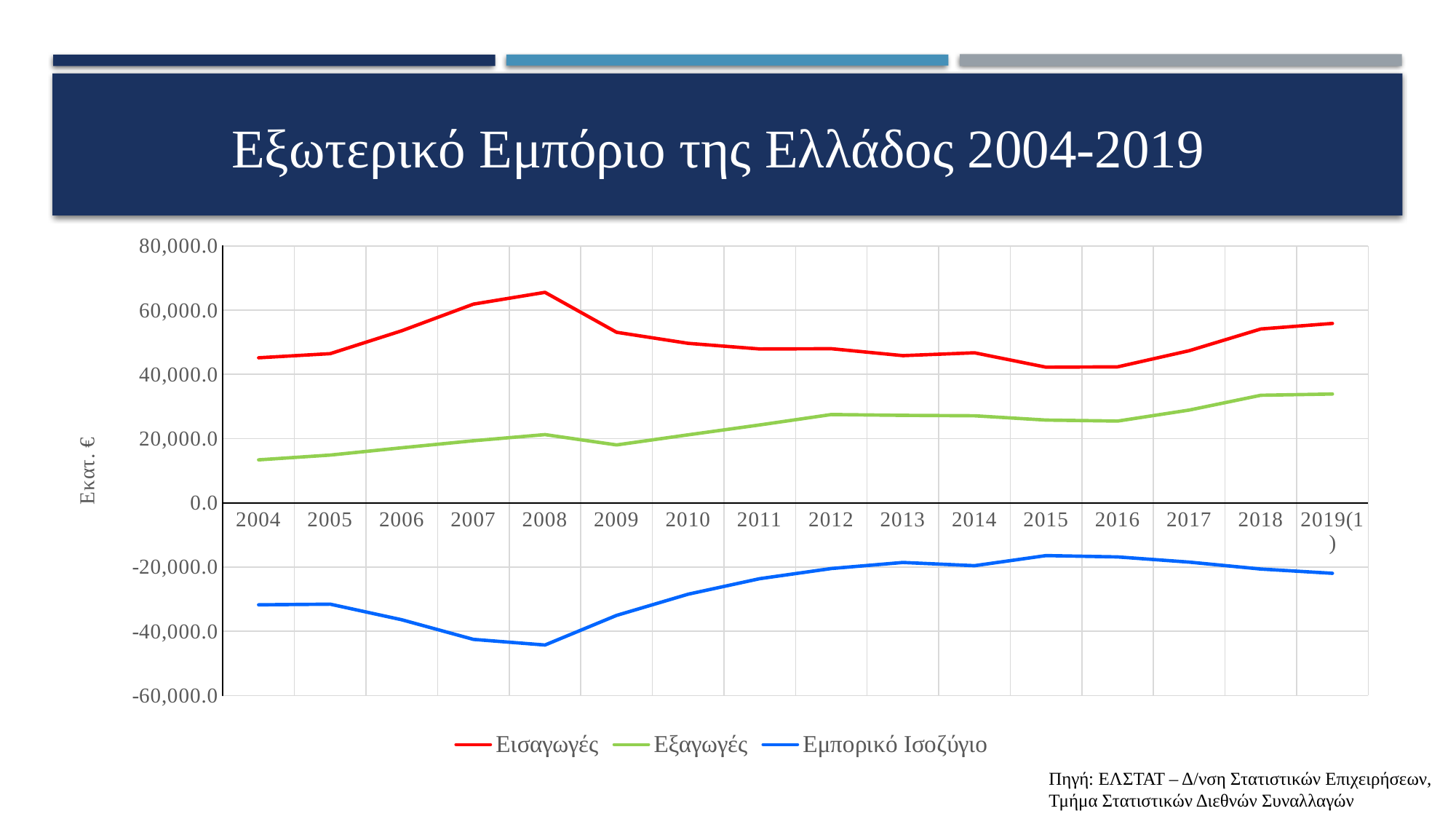
In which year is the Εξαγωγές series at its lowest? 2004 Is the value for Εμπορικό Ισοζύγιο in 2008 greater or less than -40,000.0? less Is the value for Εξαγωγές in 2004 greater or less than 20,000.0? less Do the Εισαγωγές values rise or fall from 2004 to 2008? rise Which is larger, the Εισαγωγές value in 2008 or in 2004? 2008 What is the title of the chart? Εξωτερικό Εμπόριο της Ελλάδος 2004-2019 What kind of chart is shown on the slide? line chart How many years are plotted along the x axis? 16 In which year does the Εισαγωγές series reach its highest value? 2008 How many series does the legend list? 3 Is the value for Εισαγωγές in 2008 greater or less than 60,000.0? greater In which year is the Εμπορικό Ισοζύγιο series at its lowest (most negative)? 2008